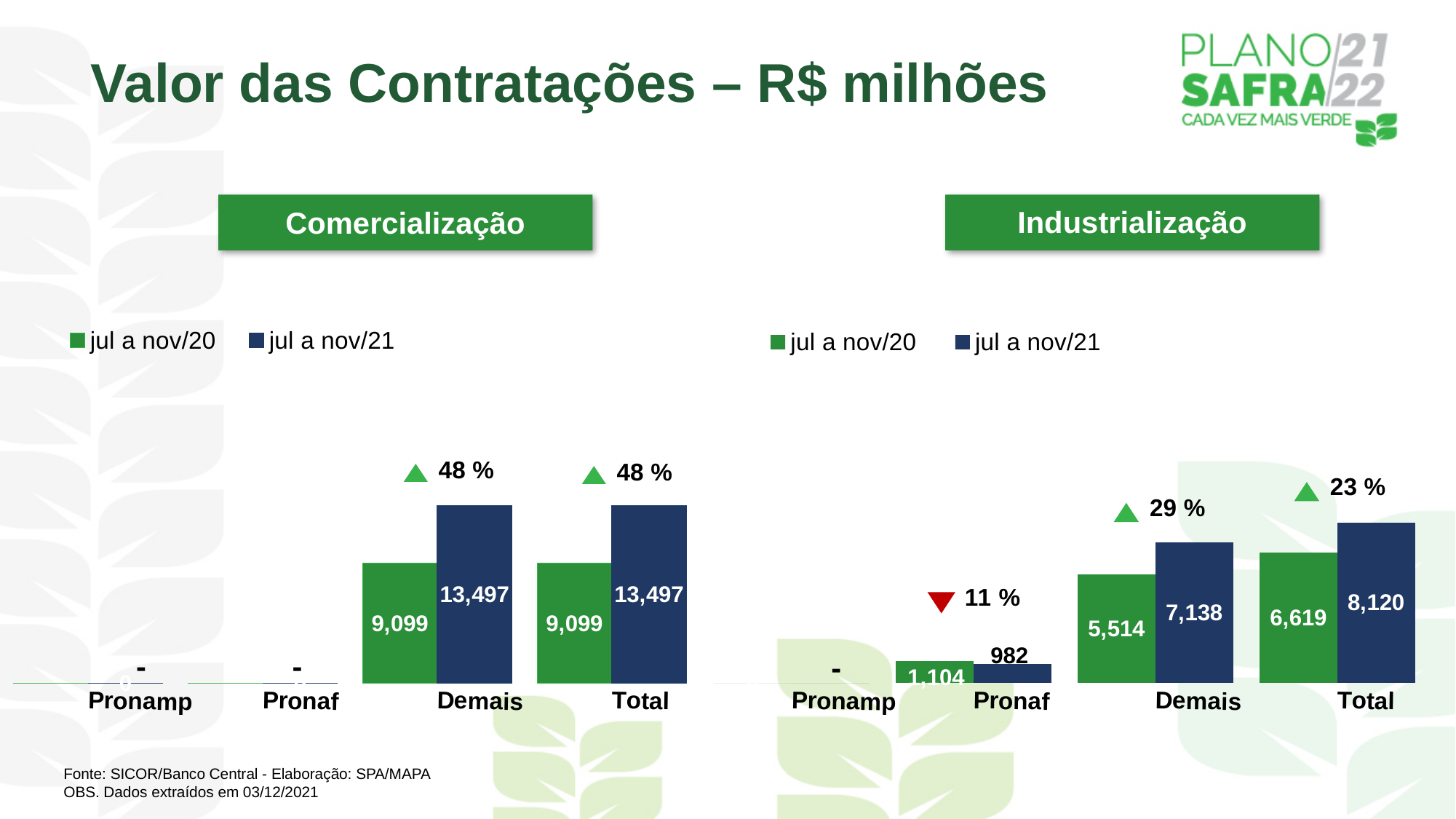
In the Industrialização chart, what is the value for Total in jul a nov/21? 8,120 In the Industrialização chart, what is the value for Demais in jul a nov/21? 7,138 In the Comercialização chart, what is the value for Total in jul a nov/20? 9,099 In the Comercialização chart, what is the difference between the Demais values for jul a nov/21 and jul a nov/20? 4,398 In the Industrialização chart, what is the difference between the Total values for jul a nov/21 and jul a nov/20? 1,501 In the Comercialização chart, what is the value for Demais in jul a nov/21? 13,497 How many categories are shown on the x axis of the Industrialização chart? 4 In the Industrialização chart, what is the value for Pronaf in jul a nov/20? 1,104 How many series does the legend of the Comercialização chart list? 2 In the Industrialização chart, which is larger for Pronaf: jul a nov/20 or jul a nov/21? jul a nov/20 In the Industrialização chart, which category has the lowest value in jul a nov/21 among those with a plotted bar? Pronaf What kind of chart is the Comercialização chart? Bar chart